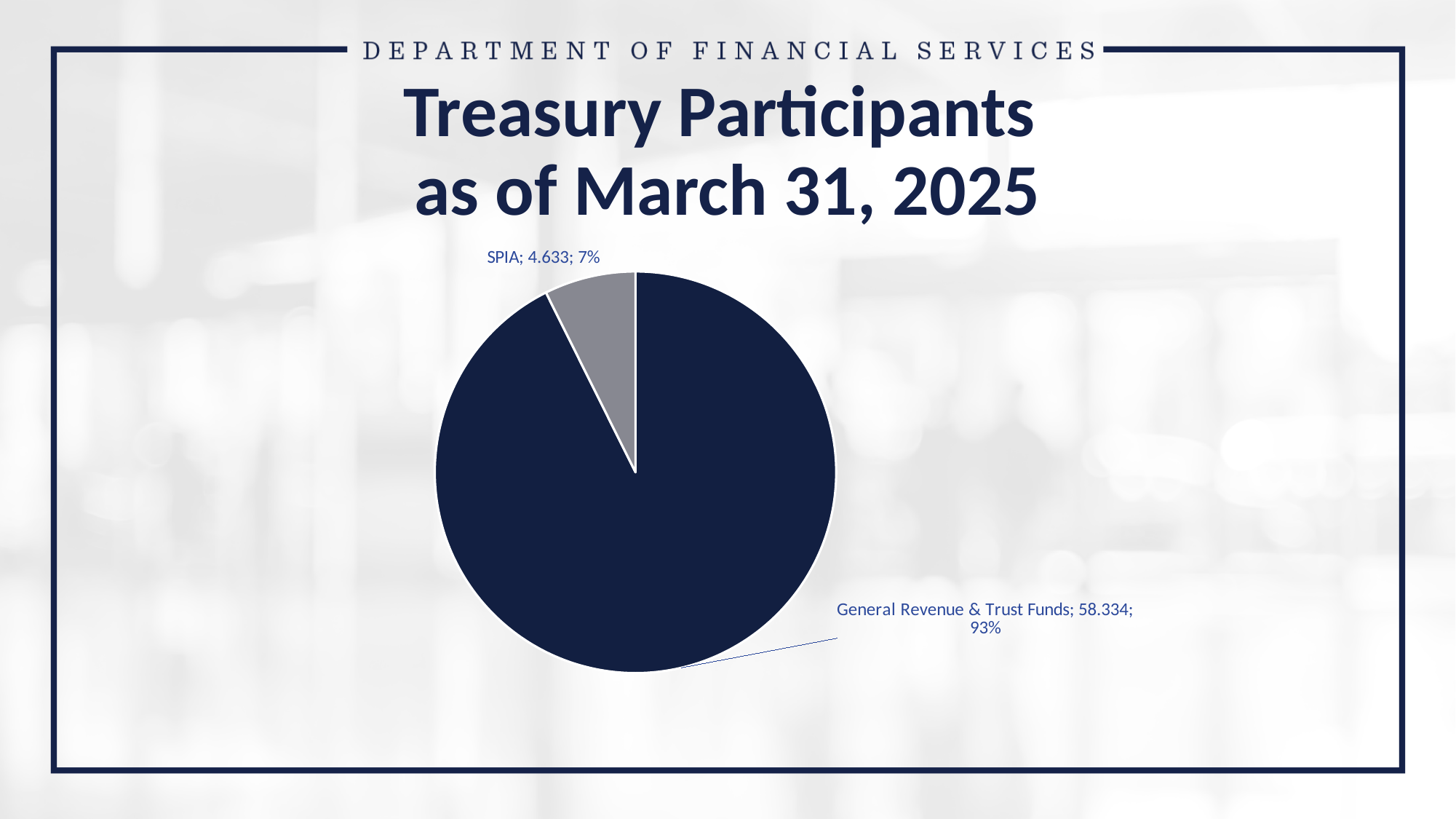
What share of the pie does SPIA represent? 7% What kind of chart is shown on the slide? pie chart Which slice is the largest? General Revenue & Trust Funds Which slice is the smallest? SPIA What is the value for General Revenue & Trust Funds? 58.334 What colour is the SPIA slice? grey Which is larger, SPIA or General Revenue & Trust Funds? General Revenue & Trust Funds What is the difference between the values for General Revenue & Trust Funds and SPIA? 53.701 How many slices does the pie chart have? 2 What is the title of the chart? Treasury Participants as of March 31, 2025 What is the value for SPIA? 4.633 What share of the pie does General Revenue & Trust Funds represent? 93%